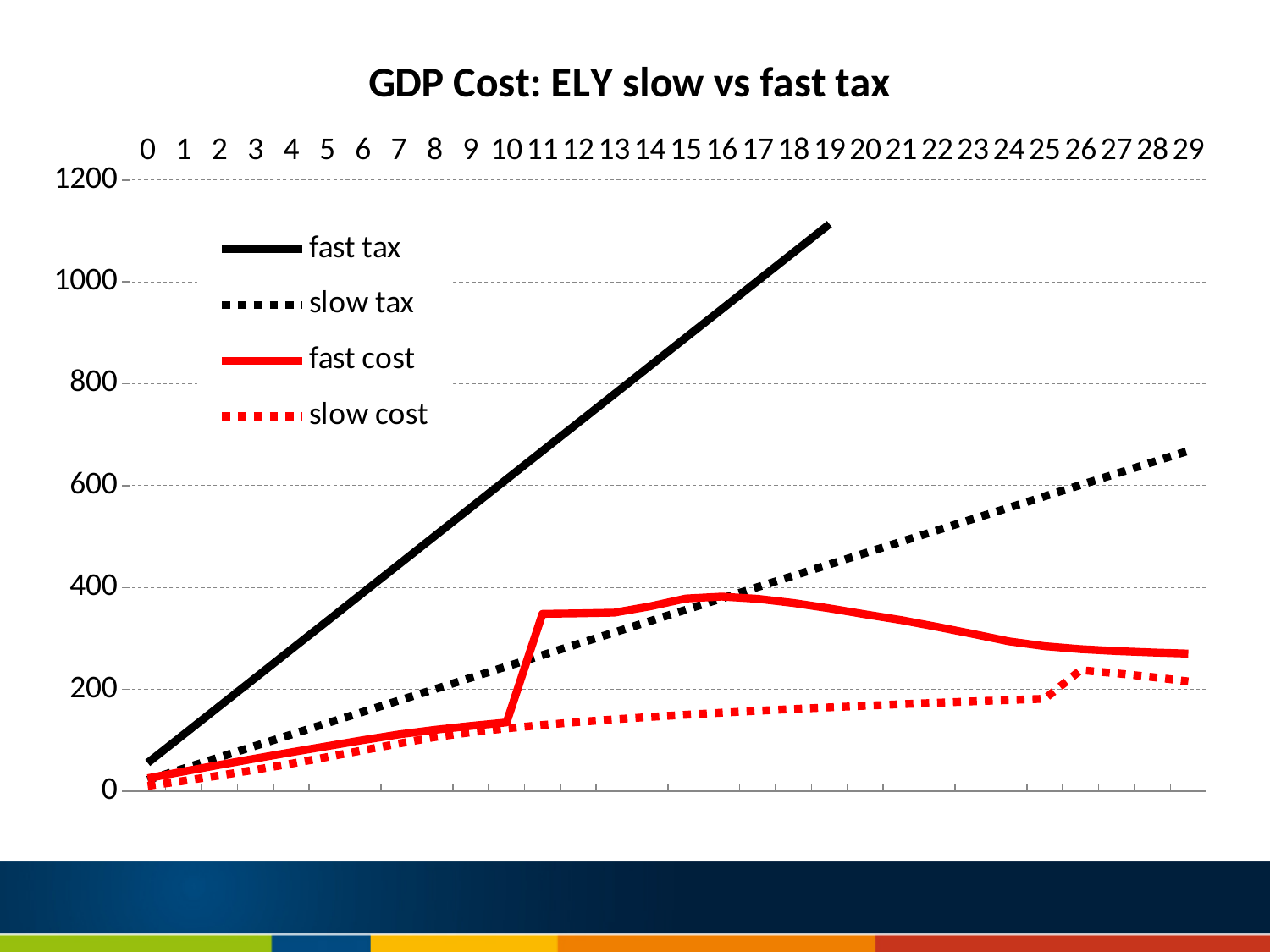
Which series reaches the highest value on the chart? fast tax Is the value of slow tax at x = 29 greater or less than 600? greater What is the title of the chart? GDP Cost: ELY slow vs fast tax At x = 29, which is larger, fast cost or slow cost? fast cost Is the value of fast cost at x = 11 greater or less than 200? greater How many points are labelled along the x axis? 30 Is the value of slow cost at x = 29 greater or less than 400? less How many series does the legend list? 4 At x = 15, which is larger, fast tax or slow tax? fast tax Does the slow tax series rise or fall along the x axis? rise What kind of chart is shown on the slide? line chart